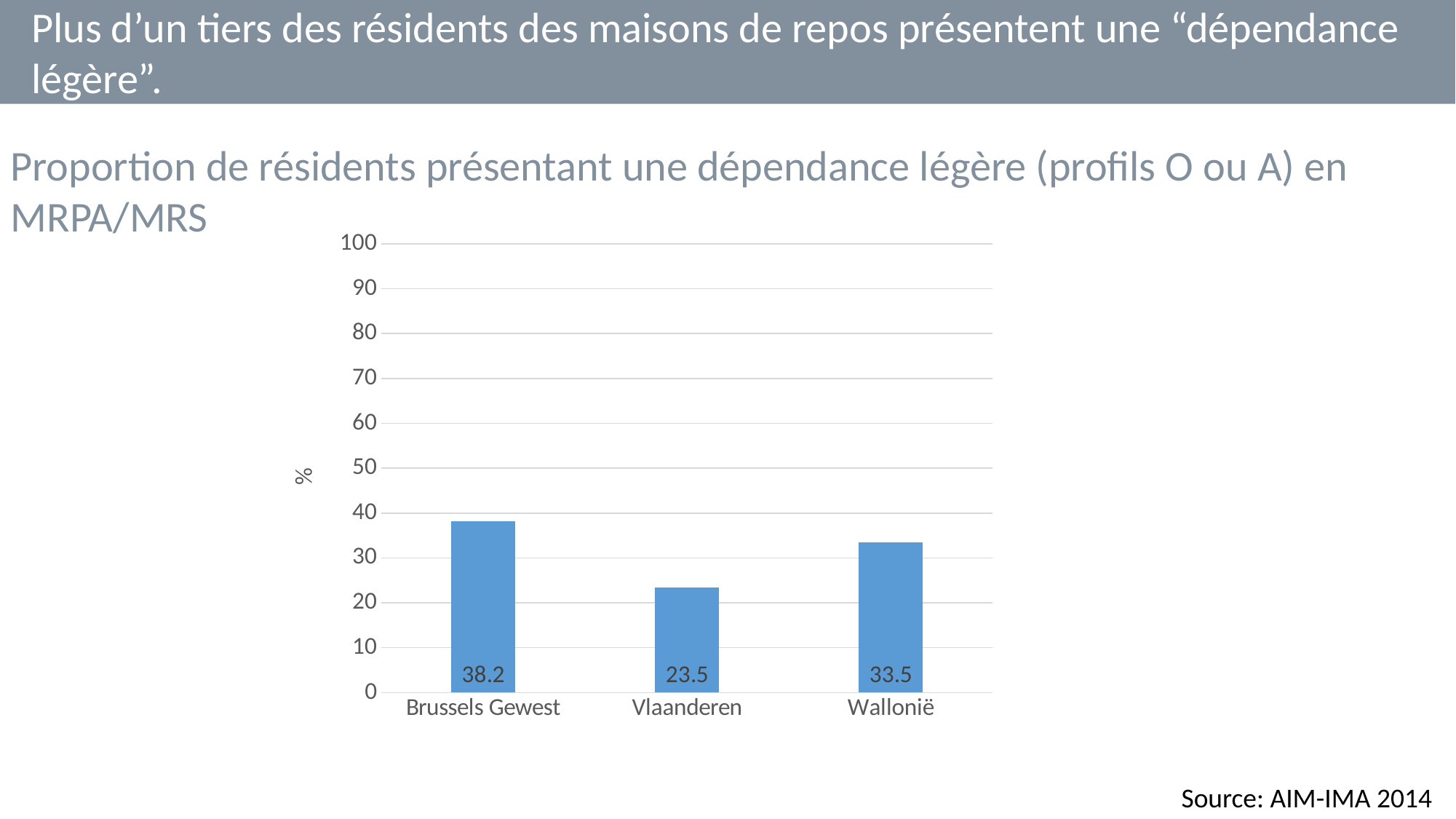
Which is larger, the value for Wallonië or the value for Vlaanderen? Wallonië Which region has the lowest proportion of residents with light dependency? Vlaanderen What is the value for Vlaanderen? 23.5 What is the value for Wallonië? 33.5 What kind of chart is shown on the slide? bar chart What is the difference between the values for Wallonië and Vlaanderen? 10 Which region has the highest proportion of residents with light dependency? Brussels Gewest What is the difference between the values for Brussels Gewest and Vlaanderen? 14.7 Is the value for Brussels Gewest greater or less than 40? less What is the value for Brussels Gewest? 38.2 What is the label on the vertical axis of the chart? % How many regions are shown on the chart? 3